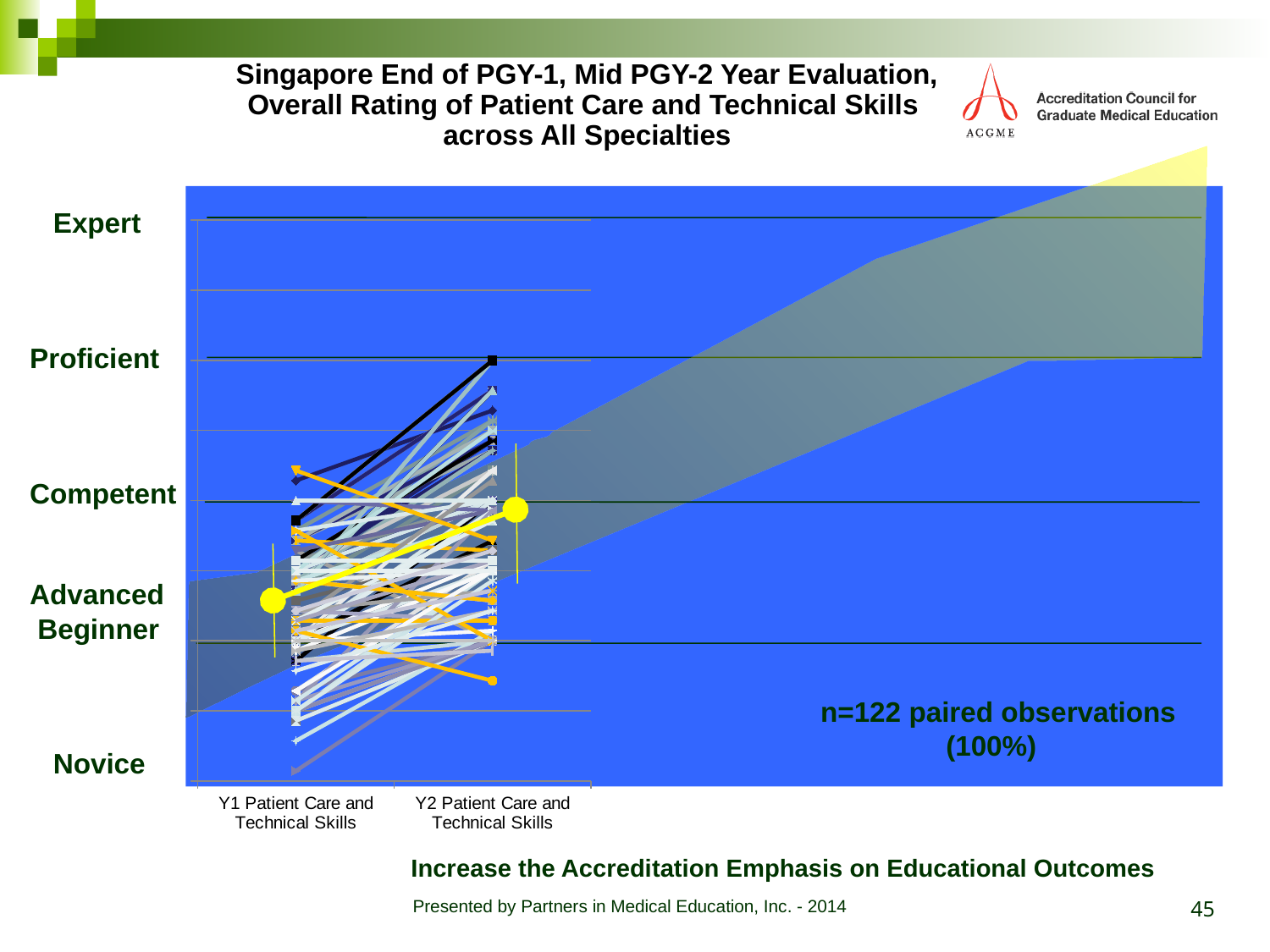
How many paired observations does the chart report? n=122 What is the highest rating level labelled on the y axis of the chart? Expert What is the lowest rating level labelled on the y axis of the chart? Novice What kind of chart is shown on the slide? Line chart How many time points (categories) are shown on the x axis of the chart? 2 Is the Y1 mean rating (large yellow marker) above or below the Competent level? Below Which time point has the higher mean rating in the chart, Y1 or Y2? Y2 Patient Care and Technical Skills What are the two categories labelled on the x axis of the chart? Y1 Patient Care and Technical Skills; Y2 Patient Care and Technical Skills What percentage of observations is stated next to the n=122 label on the chart? 100% How many rating levels are labelled on the y axis of the chart? 5 Is the Y2 mean rating (large yellow marker) above or below the Advanced Beginner level? Above Does the overall (mean) rating rise or fall from Y1 to Y2 in the chart? Rise